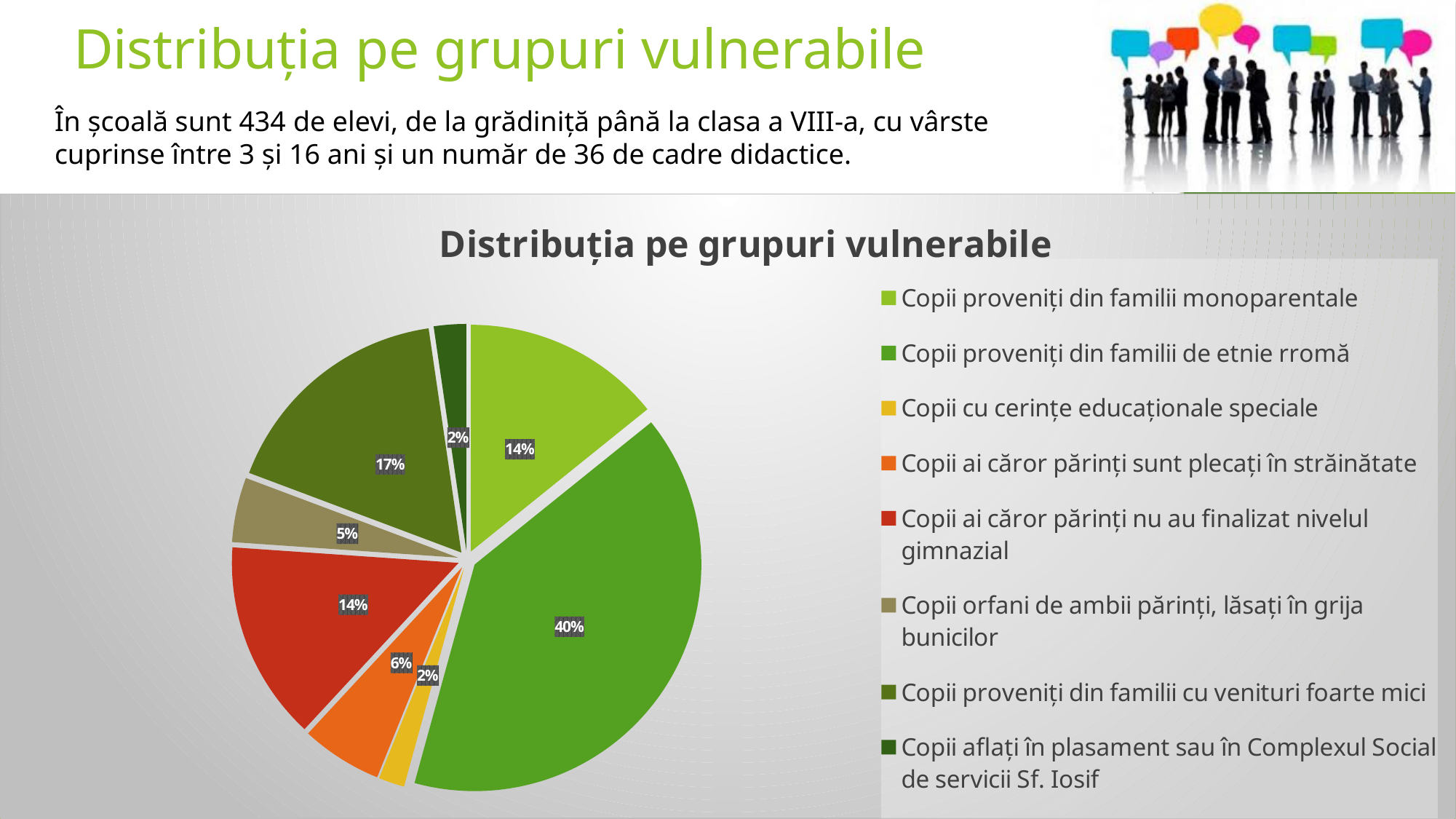
What percentage is shown for 'Copii proveniți din familii monoparentale'? 14% Which category has the largest share of the pie? Copii proveniți din familii de etnie rromă What type of chart is shown on the slide? Pie chart What percentage is shown for 'Copii proveniți din familii cu venituri foarte mici'? 17% What percentage is shown for 'Copii orfani de ambii părinți, lăsați în grija bunicilor'? 5% What is the title of the chart? Distribuția pe grupuri vulnerabile Which is larger: the share for 'Copii ai căror părinți nu au finalizat nivelul gimnazial' or the share for 'Copii ai căror părinți sunt plecați în străinătate'? Copii ai căror părinți nu au finalizat nivelul gimnazial What percentage is shown for 'Copii ai căror părinți sunt plecați în străinătate'? 6% How many categories does the pie chart have? 8 What colour is the slice for 'Copii cu cerințe educaționale speciale'? Yellow What percentage of the pie is 'Copii proveniți din familii de etnie rromă'? 40% What is the difference in percentage points between 'Copii proveniți din familii de etnie rromă' and 'Copii proveniți din familii cu venituri foarte mici'? 23